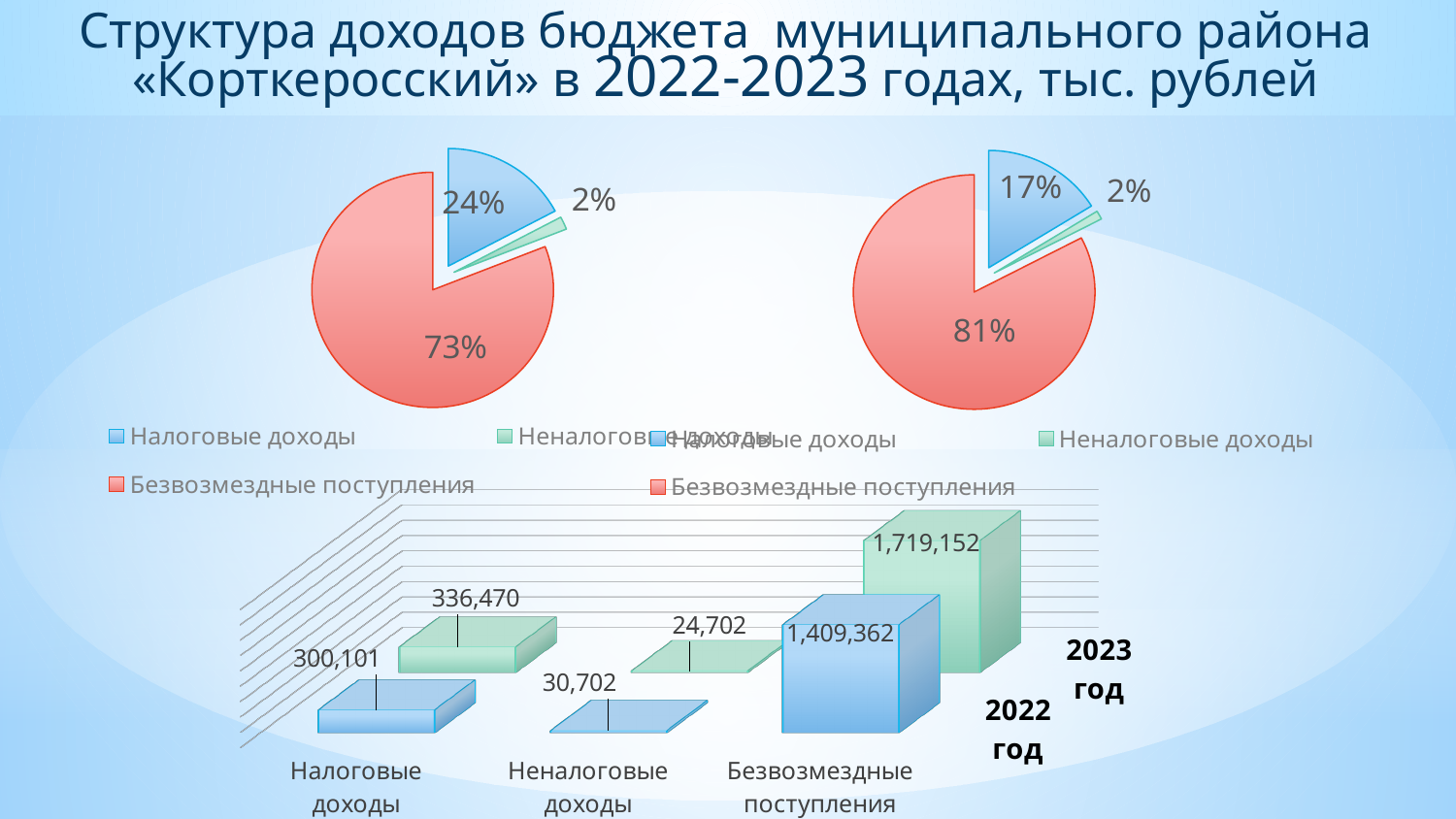
In the right pie chart, what share does the slice for Налоговые доходы have? 17% In the bottom bar chart, what is the value for Налоговые доходы in 2022 год? 300,101 In the bottom bar chart, which is larger: Неналоговые доходы in 2022 год or in 2023 год? 2022 год What type of chart is shown at the bottom of the slide? Bar chart How many slices does the right pie chart have? 3 In the left pie chart, what share does the largest slice (Безвозмездные поступления) have? 73% In the bottom bar chart, what is the difference between Безвозмездные поступления in 2023 год and in 2022 год? 309,790 In the bottom bar chart, what is the value for Неналоговые доходы in 2023 год? 24,702 In the left pie chart, which category has the smallest slice? Неналоговые доходы In the right pie chart, which category has the largest slice? Безвозмездные поступления In the bottom bar chart, what is the value for Безвозмездные поступления in 2023 год? 1,719,152 In the left pie chart, what share does the slice for Неналоговые доходы have? 2%